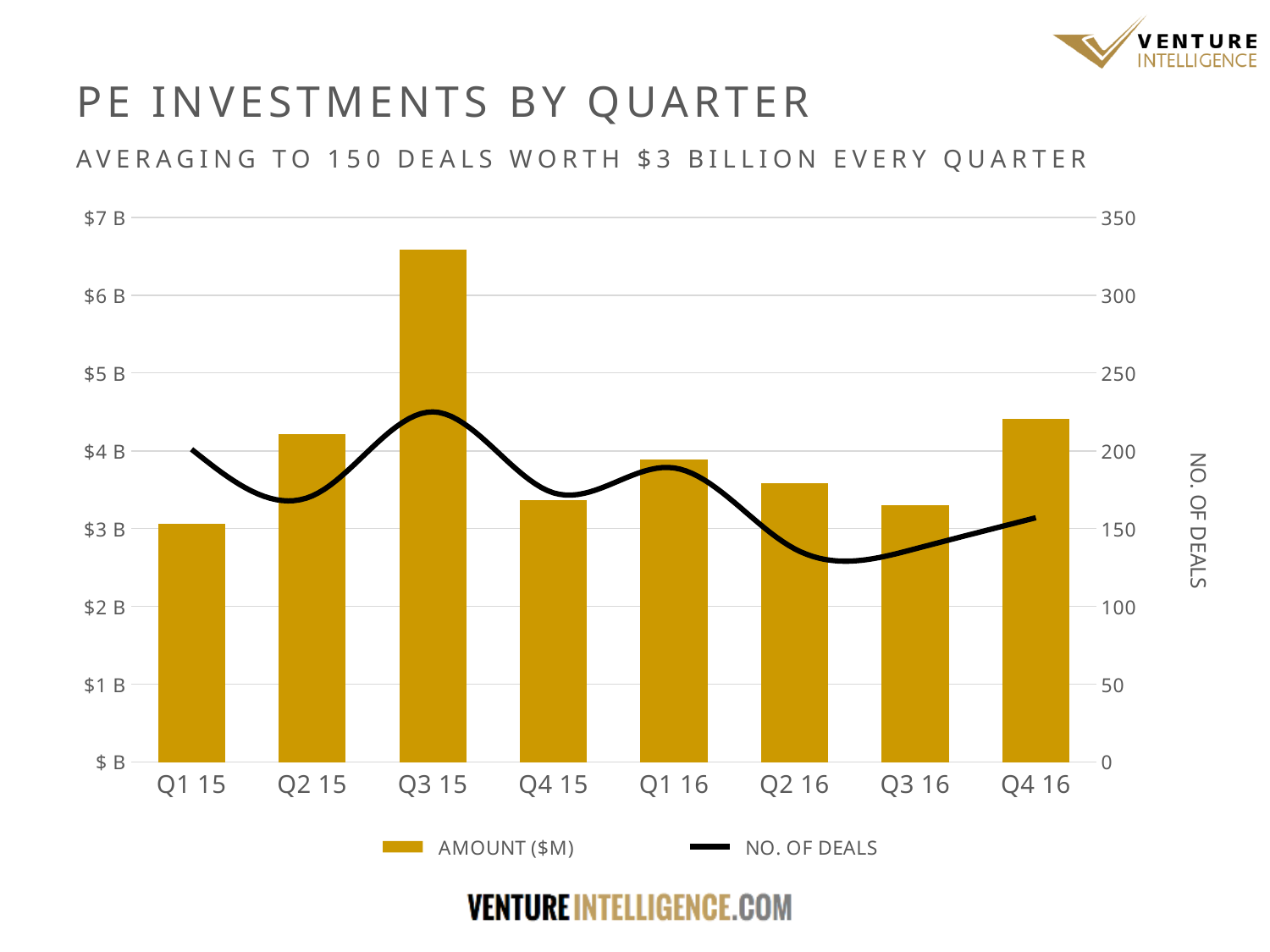
Which quarter has a larger investment amount, Q2 15 or Q4 15? Q2 15 Is the investment amount for Q4 16 greater or less than $4 B? greater What kind of chart is shown on the slide? A combined bar and line chart Is the investment amount for Q3 15 greater or less than $6 B? greater Is the number of deals in Q2 16 greater or less than 150? less Does the investment amount rise or fall from Q1 16 to Q3 16? Fall Which quarter has the highest number of deals? Q3 15 Which quarter has the highest investment amount? Q3 15 Which quarter has the lowest investment amount? Q1 15 How many series does the legend list? 2 How many quarters are shown on the x axis? 8 What is the title of the right-hand vertical axis? NO. OF DEALS